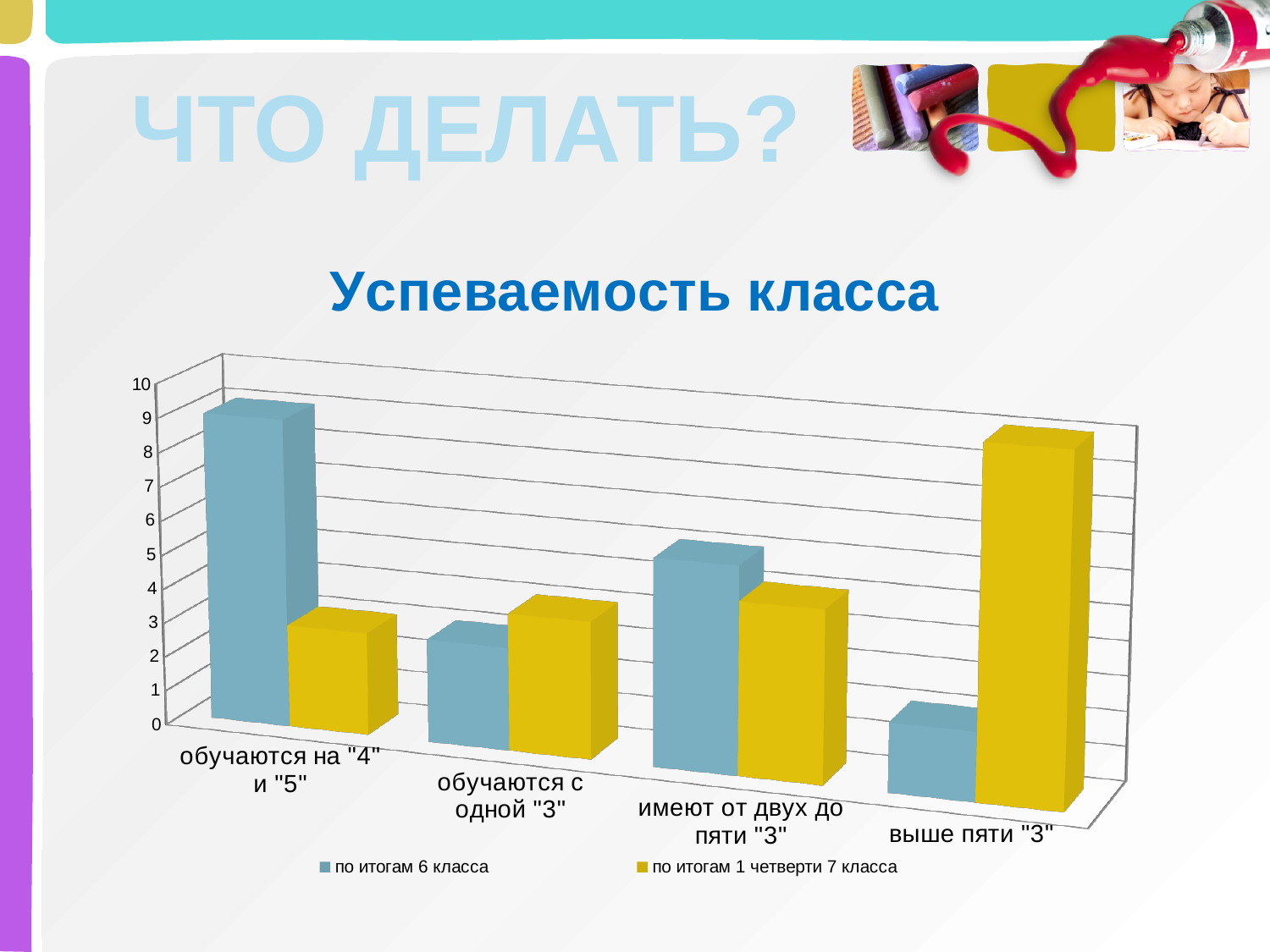
For the series "по итогам 6 класса", which category has the lowest value? выше пяти "3" How many series does the legend list? 2 In the category "обучаются на "4" и "5"", which series has the larger value? по итогам 6 класса For the series "по итогам 6 класса", which category has the highest value? обучаются на "4" и "5" Which series is shown in yellow? по итогам 1 четверти 7 класса Is the value for "обучаются на "4" и "5"" in the series "по итогам 6 класса" greater or less than 5? greater What kind of chart is shown on the slide? bar chart What is the title of the chart? Успеваемость класса In the category "выше пяти "3"", which series has the larger value? по итогам 1 четверти 7 класса Is the value for "выше пяти "3"" in the series "по итогам 1 четверти 7 класса" greater or less than 5? greater How many categories are shown on the x axis of the chart? 4 For the series "по итогам 1 четверти 7 класса", which category has the highest value? выше пяти "3"